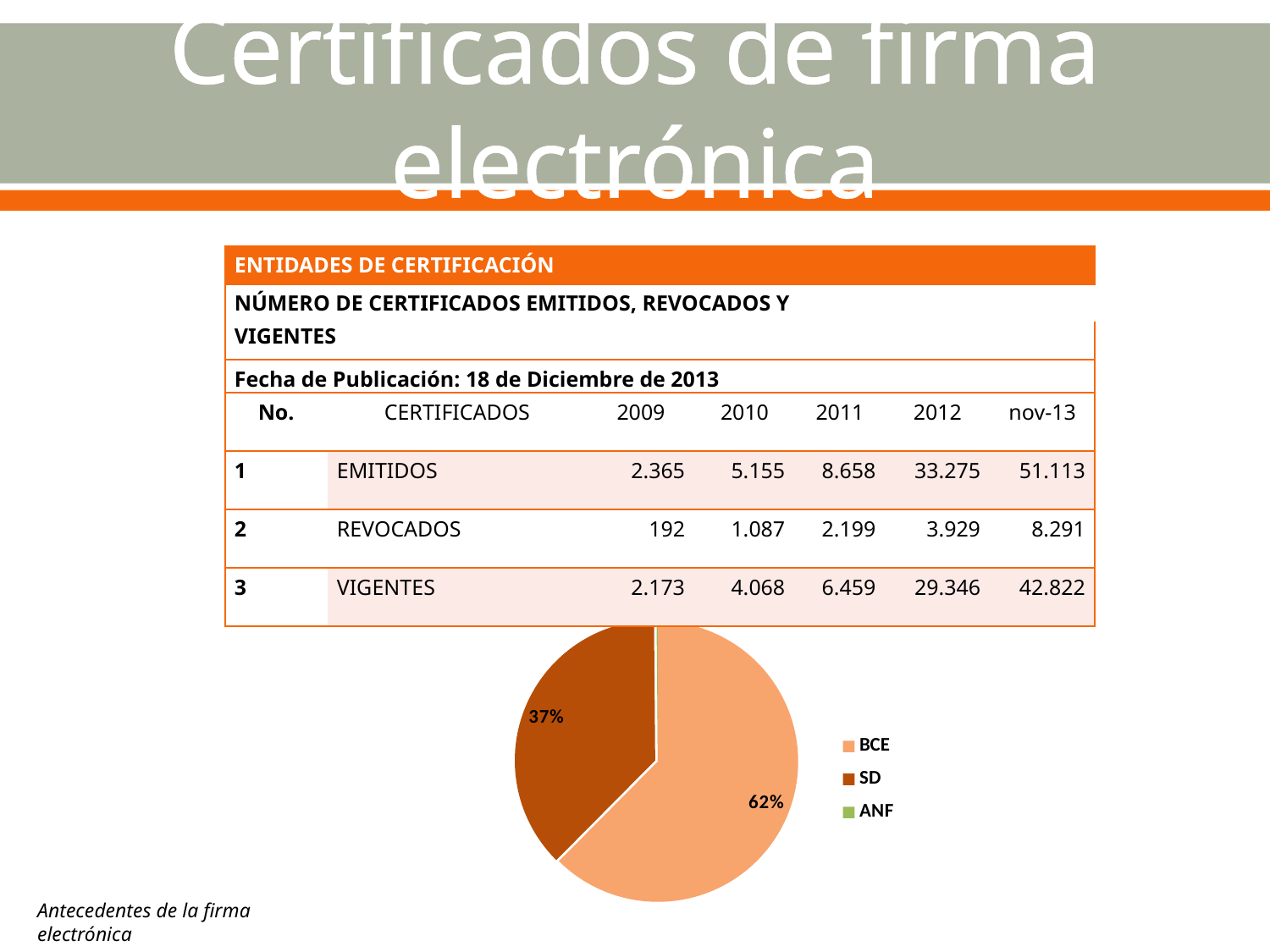
How many entries does the legend of the pie chart list? 3 Which slice is larger in the pie chart, BCE or SD? BCE What is the difference in percentage points between the BCE slice and the SD slice? 25% Which category has the smallest slice in the pie chart? ANF Is the share for SD greater or less than 50%? less What kind of chart is shown on the slide? pie chart What share of the pie chart does SD hold? 37% Which legend entries are listed in the pie chart? BCE, SD, ANF Which category has the largest slice in the pie chart? BCE What share of the pie chart does BCE hold? 62% Is the share for BCE greater or less than 50%? greater What colour is the BCE slice in the pie chart? light orange